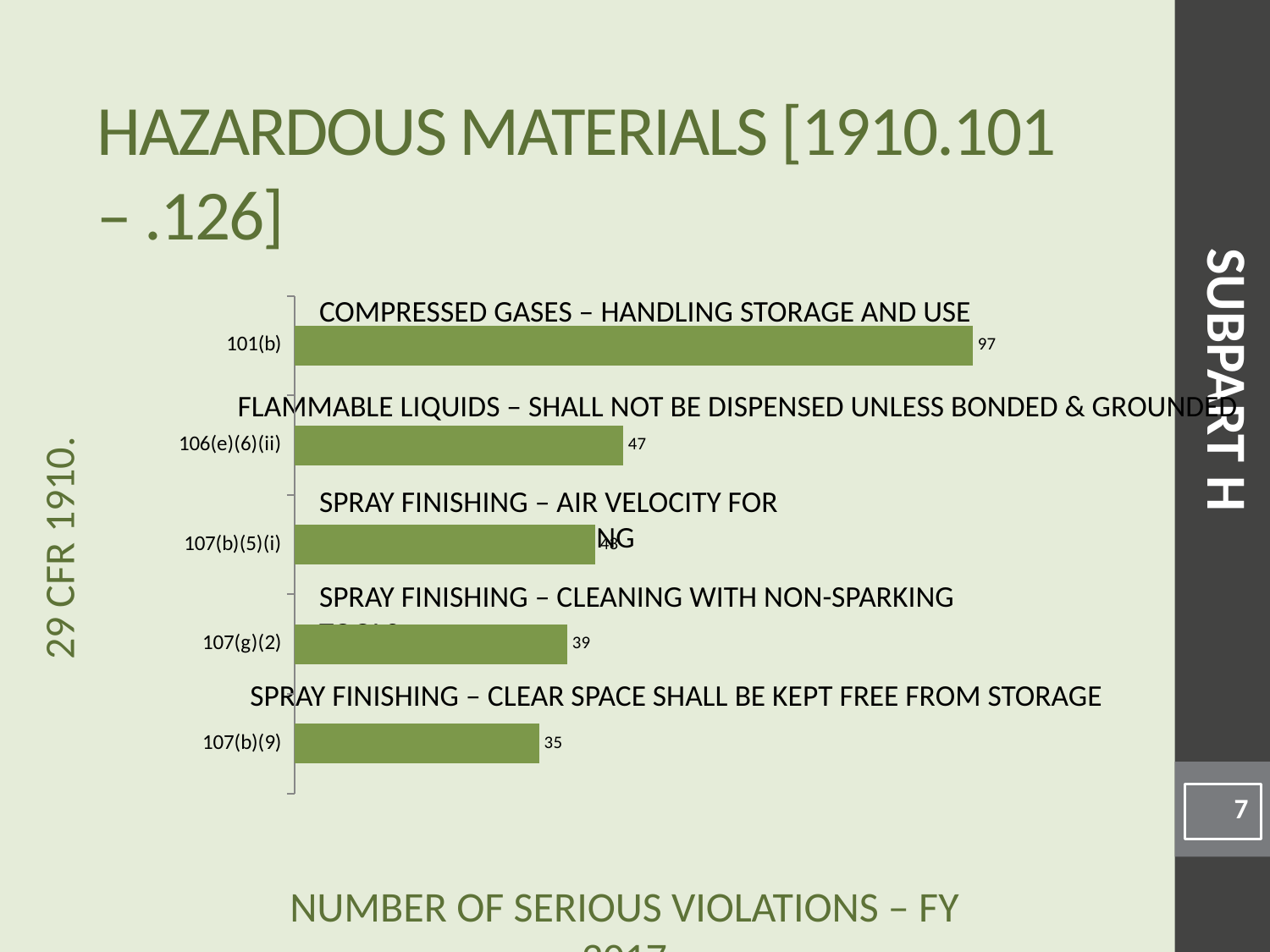
What is the value for 107(b)(9)? 35 What is the difference between the values for 101(b) and 106(e)(6)(ii)? 50 Which category has the highest value? 101(b) How many categories are shown in the chart? 5 What is the value for 101(b)? 97 Which is larger, the value for 106(e)(6)(ii) or the value for 107(g)(2)? 106(e)(6)(ii) What is the difference between the values for 107(g)(2) and 107(b)(9)? 4 What is the value for 107(g)(2)? 39 Do the bar values increase or decrease from the top category to the bottom category? Decrease What is the value for 106(e)(6)(ii)? 47 What kind of chart is shown on the slide? Bar chart Which category has the lowest value? 107(b)(9)